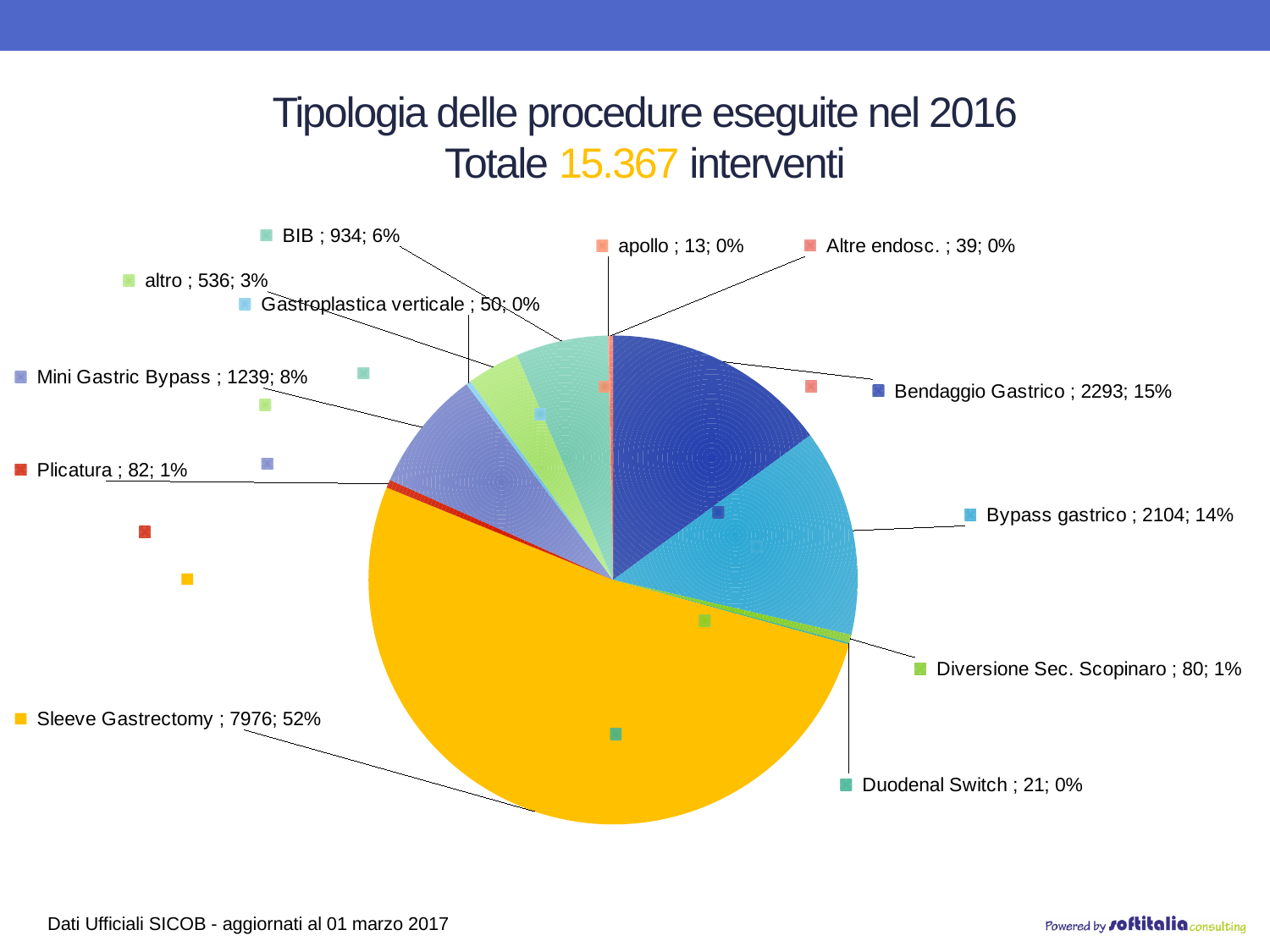
What percentage share does Mini Gastric Bypass have? 8% What kind of chart is shown on the slide? pie chart How many interventions are shown for Bypass gastrico? 2104 How many procedure categories are shown in the pie chart? 12 What total number of interventions is stated in the chart title? 15.367 How many interventions are shown for Duodenal Switch? 21 Which procedure has the largest slice of the pie? Sleeve Gastrectomy Which procedure has the smallest number of interventions? apollo Which has more interventions, Mini Gastric Bypass or BIB? Mini Gastric Bypass What is the difference in interventions between Bendaggio Gastrico and Bypass gastrico? 189 How many interventions are shown for Sleeve Gastrectomy? 7976 What percentage share does Bendaggio Gastrico have? 15%